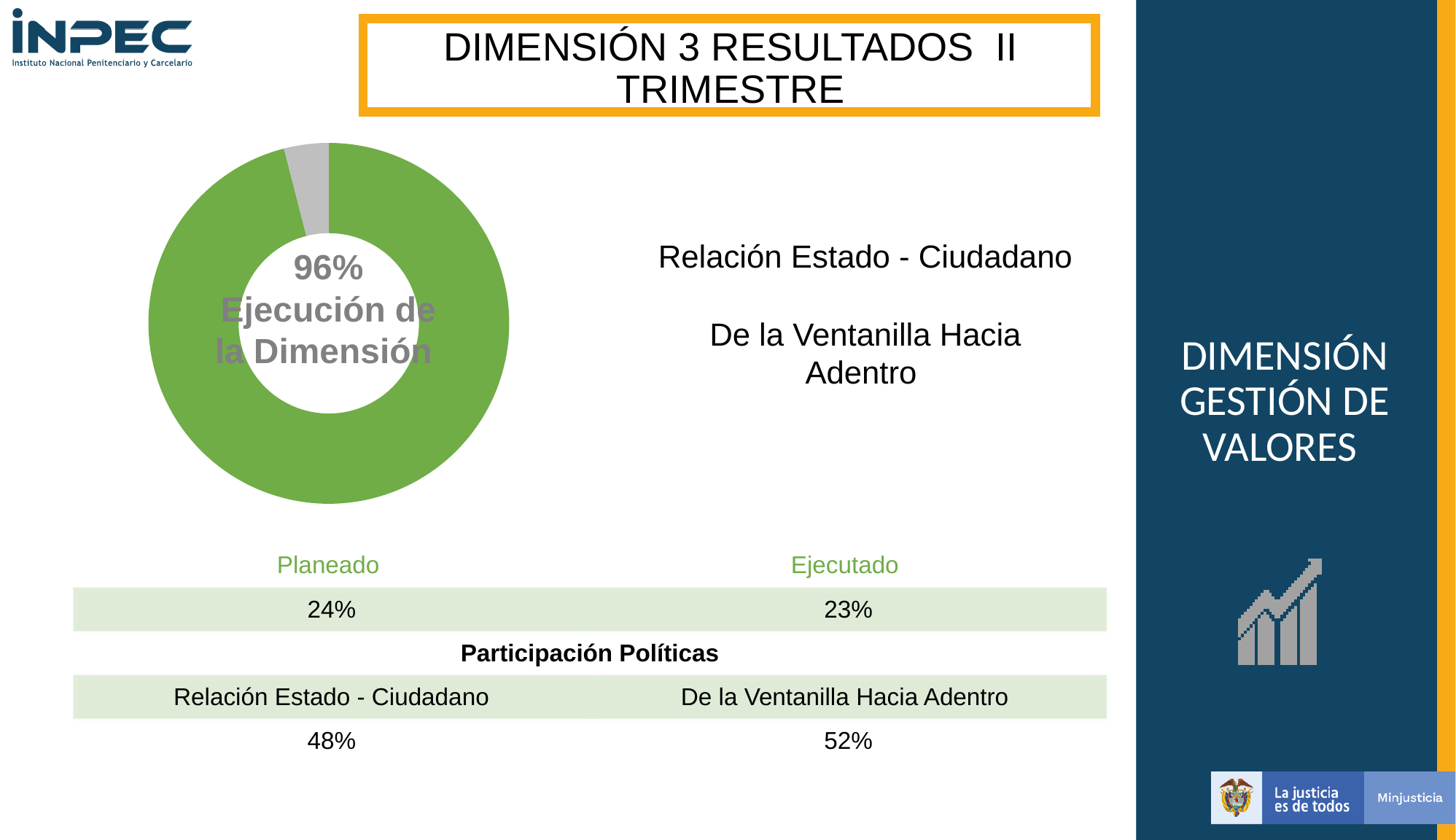
What share of the donut chart does the green slice represent? 96% What does the 96% in the donut chart represent, according to the text inside it? Ejecución de la Dimensión Which slice of the donut chart is larger, the green one or the grey one? The green one What percentage is printed in the centre of the donut chart? 96% What kind of chart is shown on the left of the slide? Donut (pie) chart Is the green slice of the donut chart greater or less than 50% of the whole? greater What colour is the largest slice of the donut chart? Green How many slices does the donut chart have? 2